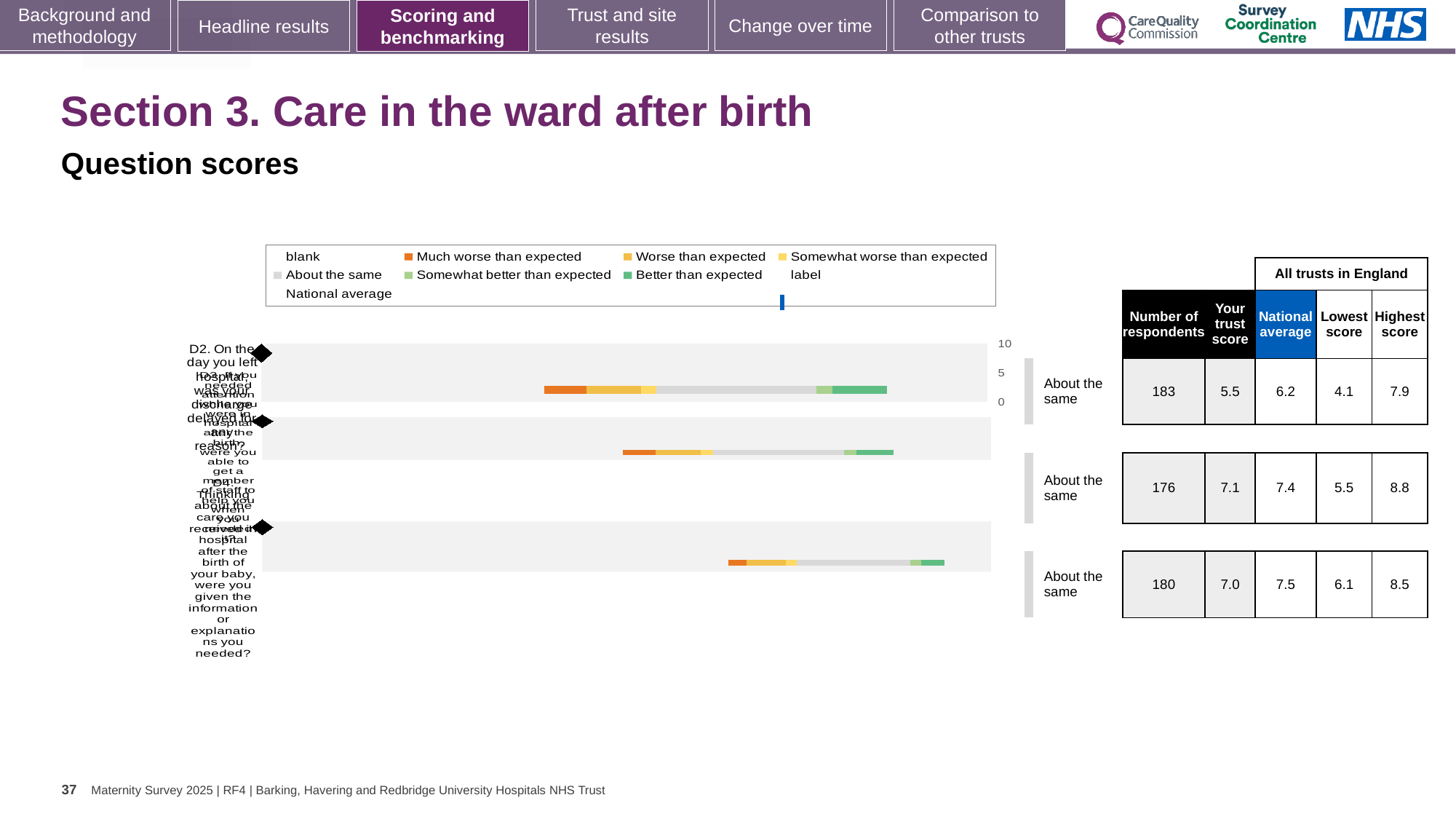
In the table beside the chart, what benchmark label is given for all three rows? About the same In the table beside the chart, what is the difference between the national average and the trust score in the top row? 0.7 What kind of chart is shown on the slide? bar chart How many entries does the chart legend list? 9 In the table beside the chart, what is the national average for the middle row? 7.4 In the table beside the chart, which row has the highest number of respondents? the top row (183) How many question rows (bars) are plotted in the chart? 3 In the chart legend, which entry is shown in dark green? Better than expected In the table beside the chart, what is the trust score for the top row? 5.5 In the table beside the chart, what is the highest score for the bottom row? 8.5 In the chart legend, which entry is shown in orange? Much worse than expected In the table beside the chart, what is the number of respondents for the top row? 183